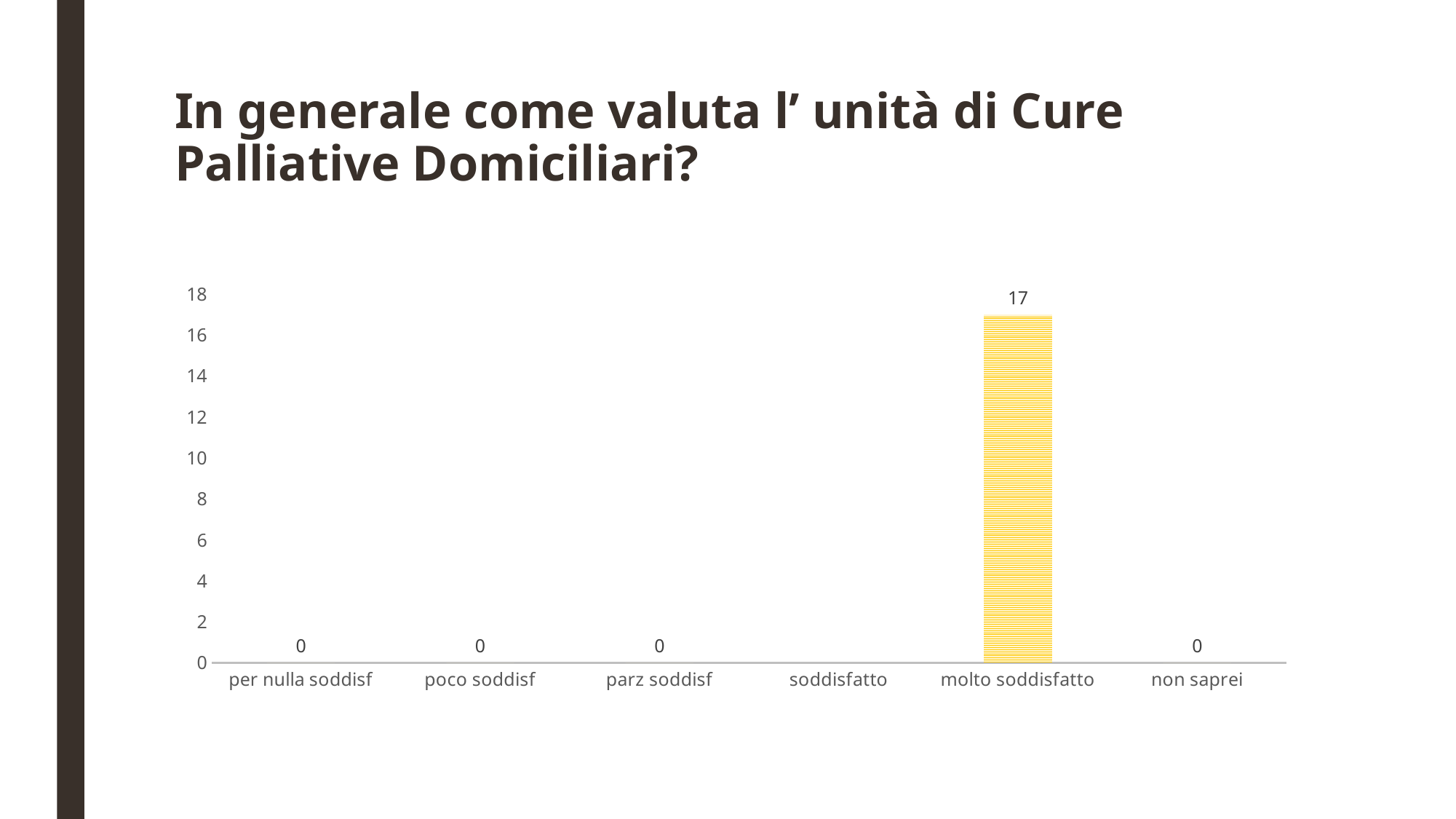
Which category has the highest value? molto soddisfatto Is the value for "molto soddisfatto" greater or less than 10? greater How many categories are shown on the x axis? 6 What is the difference between the values for "molto soddisfatto" and "parz soddisf"? 17 What is the value for "poco soddisf"? 0 What is the title of the slide? In generale come valuta l' unità di Cure Palliative Domiciliari? Which is larger, the value for "molto soddisfatto" or the value for "non saprei"? molto soddisfatto What is the highest value shown on the y axis? 18 What is the value for "non saprei"? 0 What is the value for "per nulla soddisf"? 0 What kind of chart is shown on the slide? bar chart What is the value for "molto soddisfatto"? 17